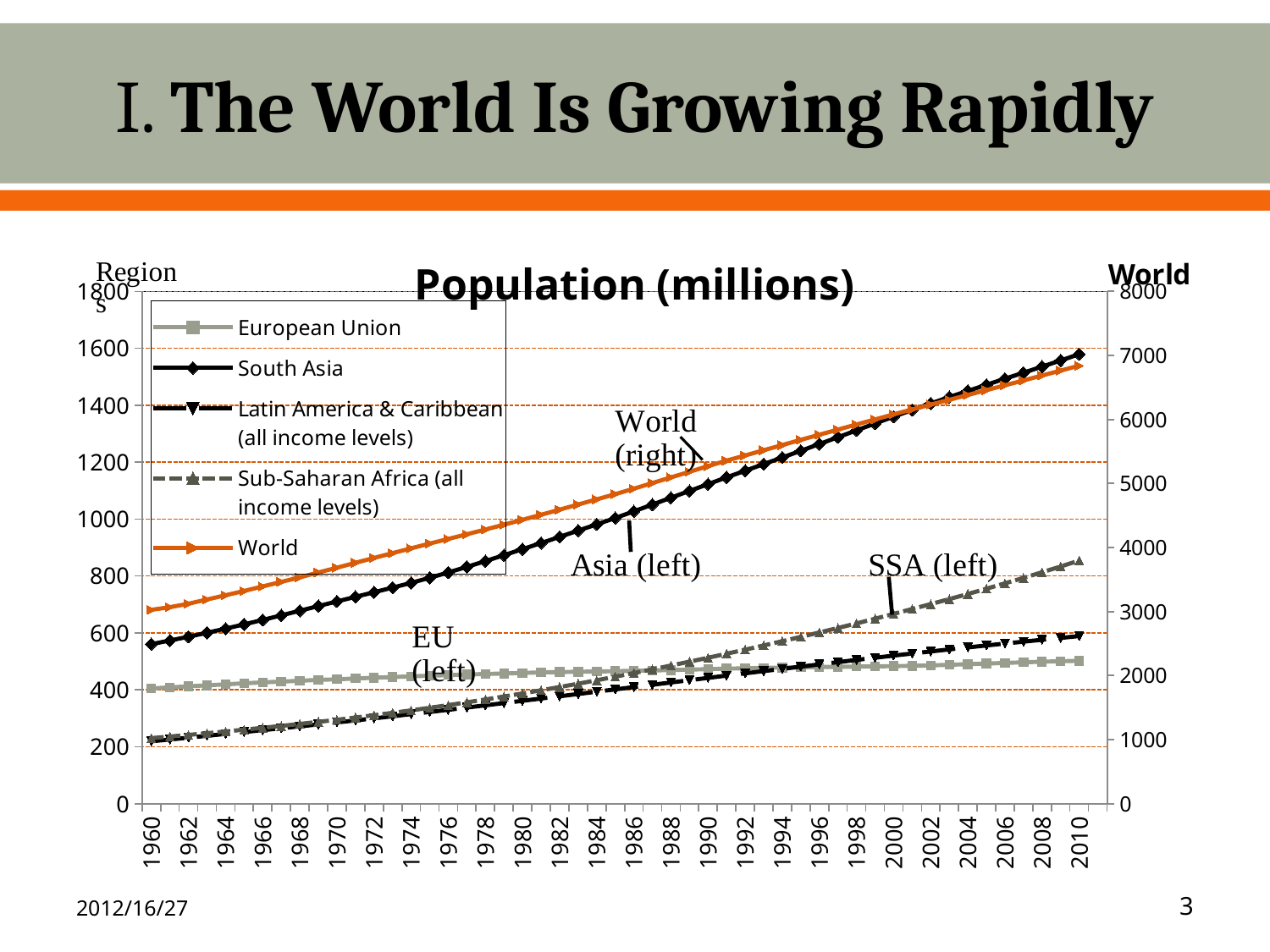
How many series does the legend list? 5 Which series is plotted against the right-hand axis? World Is the value for the European Union in 2010 greater or less than 400? greater Is the value for Sub-Saharan Africa (all income levels) in 2010 greater or less than 800? greater Is the value for South Asia in 2010 greater or less than 1400? greater What is the title of the chart? Population (millions) What kind of chart is shown on the slide? line chart Does the South Asia series rise or fall from 1960 to 2010? rise In 2010, which is larger: Sub-Saharan Africa (all income levels) or Latin America & Caribbean (all income levels)? Sub-Saharan Africa (all income levels) Among the series plotted on the left axis, which has the highest value in 2010? South Asia